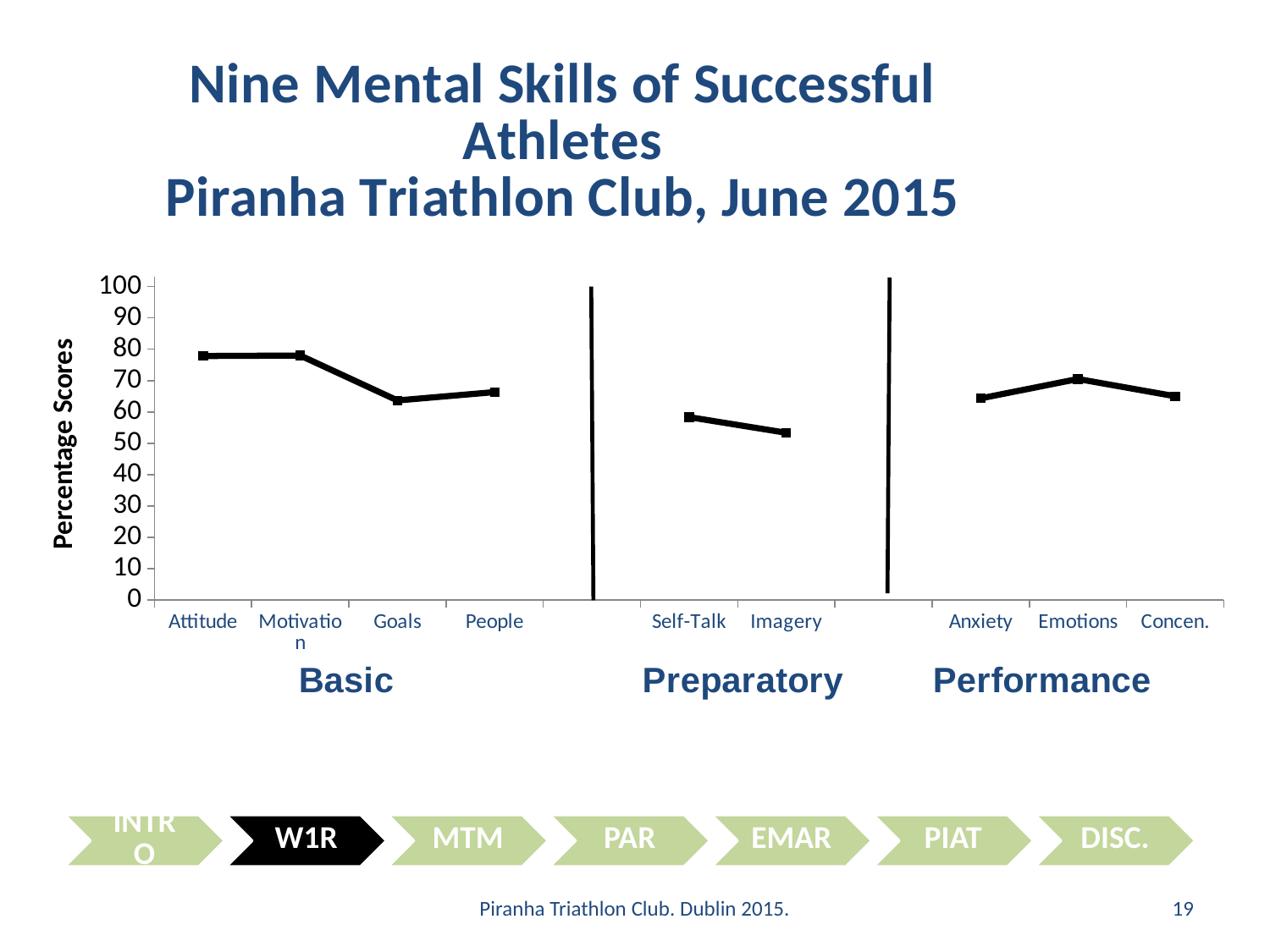
Which has the higher percentage score, Emotions or Anxiety? Emotions Which has the higher percentage score, Self-Talk or Imagery? Self-Talk Is the value for Self-Talk greater or less than 50? greater What is the label on the vertical axis of the chart? Percentage Scores Is the value for Goals greater or less than 60? greater Is the value for Attitude greater or less than 70? greater Which mental skill has the lowest percentage score? Imagery Which has the higher percentage score, Attitude or Goals? Attitude How many mental skills (categories) are plotted on the x axis? 9 Do the values rise or fall from Self-Talk to Imagery? fall What kind of chart is shown on the slide? line chart